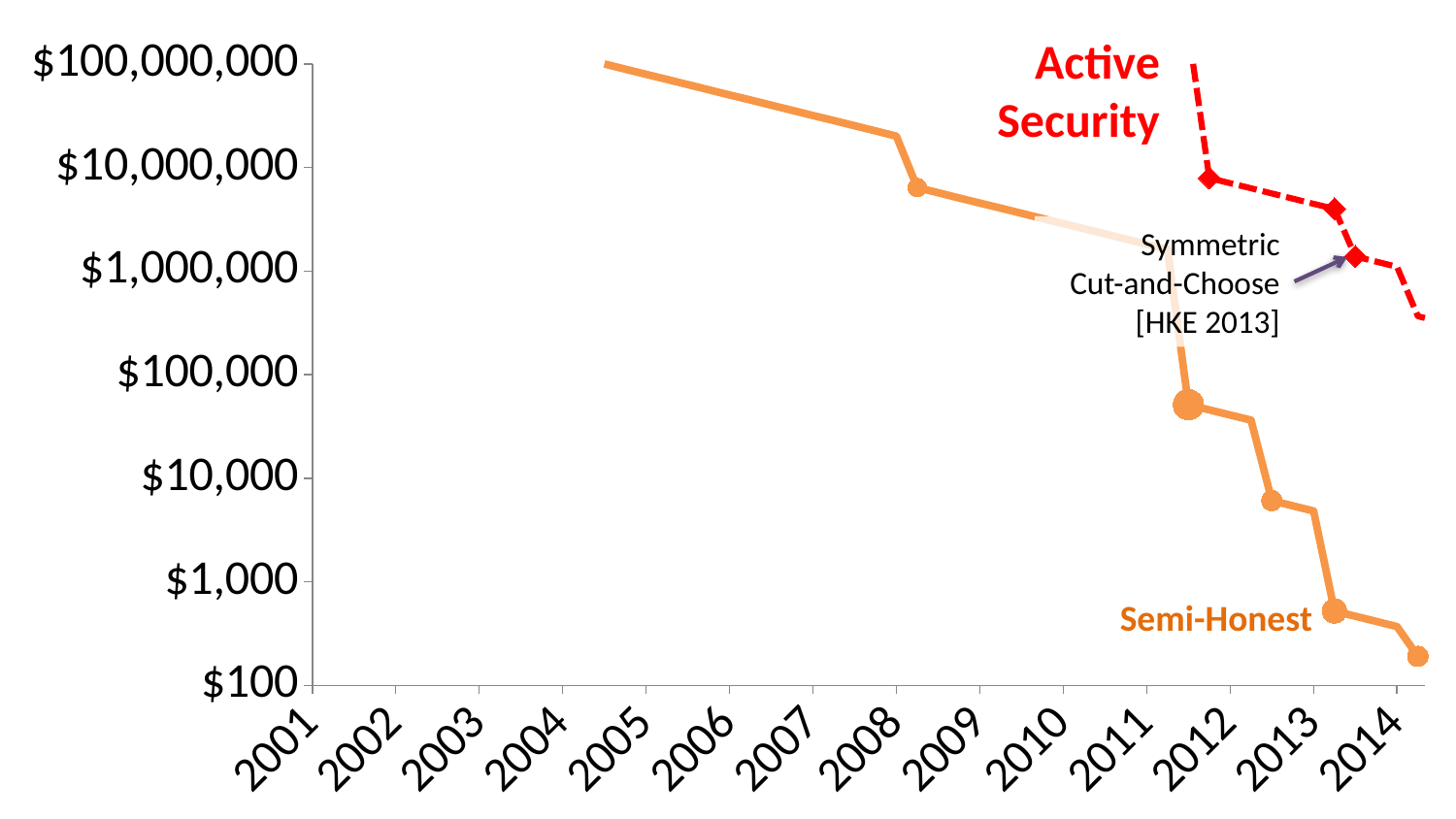
Is the Semi-Honest value at the large marker near 2011-2012 greater or less than $100,000? less How many data series are plotted on the chart? 2 What colour is the Semi-Honest line? orange What are the names of the two series plotted on the chart? Active Security and Semi-Honest Is the final (rightmost) value of the Active Security series greater or less than $1,000,000? less What kind of chart is shown on the slide? line chart Is the final (rightmost) value of the Semi-Honest series greater or less than $1,000? less Do the values of the Active Security series rise or fall over time along the x axis? fall How many year labels are shown on the x axis? 14 In 2013, which series has the higher value, Active Security or Semi-Honest? Active Security Do the values of the Semi-Honest series rise or fall over time along the x axis? fall